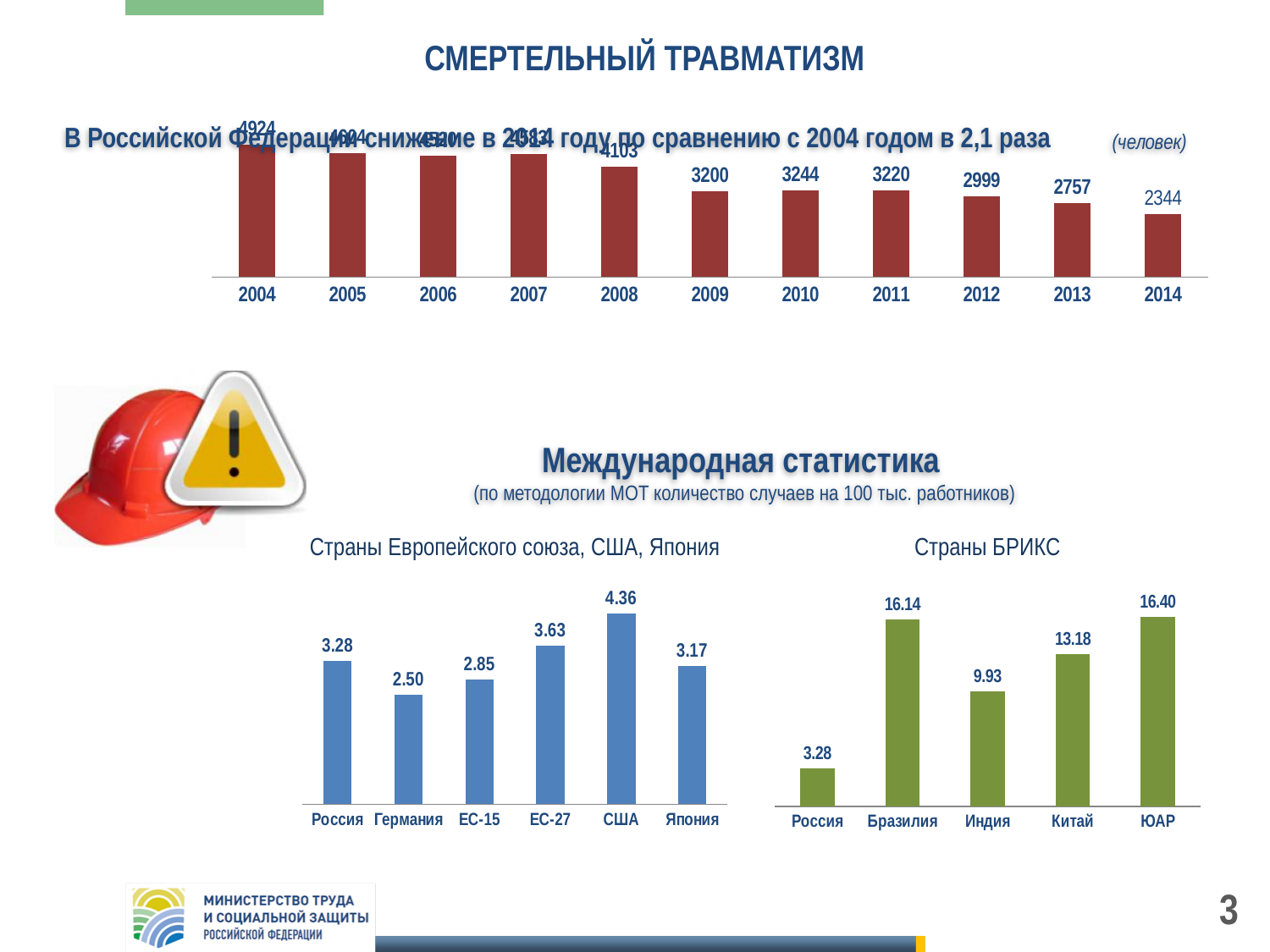
In the top chart of fatal injuries in the Russian Federation, how many years are shown on the x axis? 11 In the top chart of fatal injuries in the Russian Federation, what is the difference between the 2013 and 2014 values? 413 In the top chart of fatal injuries in the Russian Federation, what is the value for 2014? 2344 In the top chart of fatal injuries in the Russian Federation, do the values generally rise or fall from 2004 to 2014? fall In the bottom-right chart 'Страны БРИКС', which is larger, the value for Бразилия or the value for Китай? Бразилия In the bottom-right chart 'Страны БРИКС', which country has the highest value? ЮАР In the bottom-left chart 'Страны Европейского союза, США, Япония', what is the value for США? 4.36 In the bottom-left chart 'Страны Европейского союза, США, Япония', which country has the lowest value? Германия In the bottom-left chart 'Страны Европейского союза, США, Япония', what is the difference between ЕС-27 and ЕС-15? 0.78 In the top chart of fatal injuries in the Russian Federation, what is the value for 2009? 3200 In the bottom-right chart 'Страны БРИКС', what is the value for Индия? 9.93 In the top chart of fatal injuries in the Russian Federation, which year has the lowest value? 2014